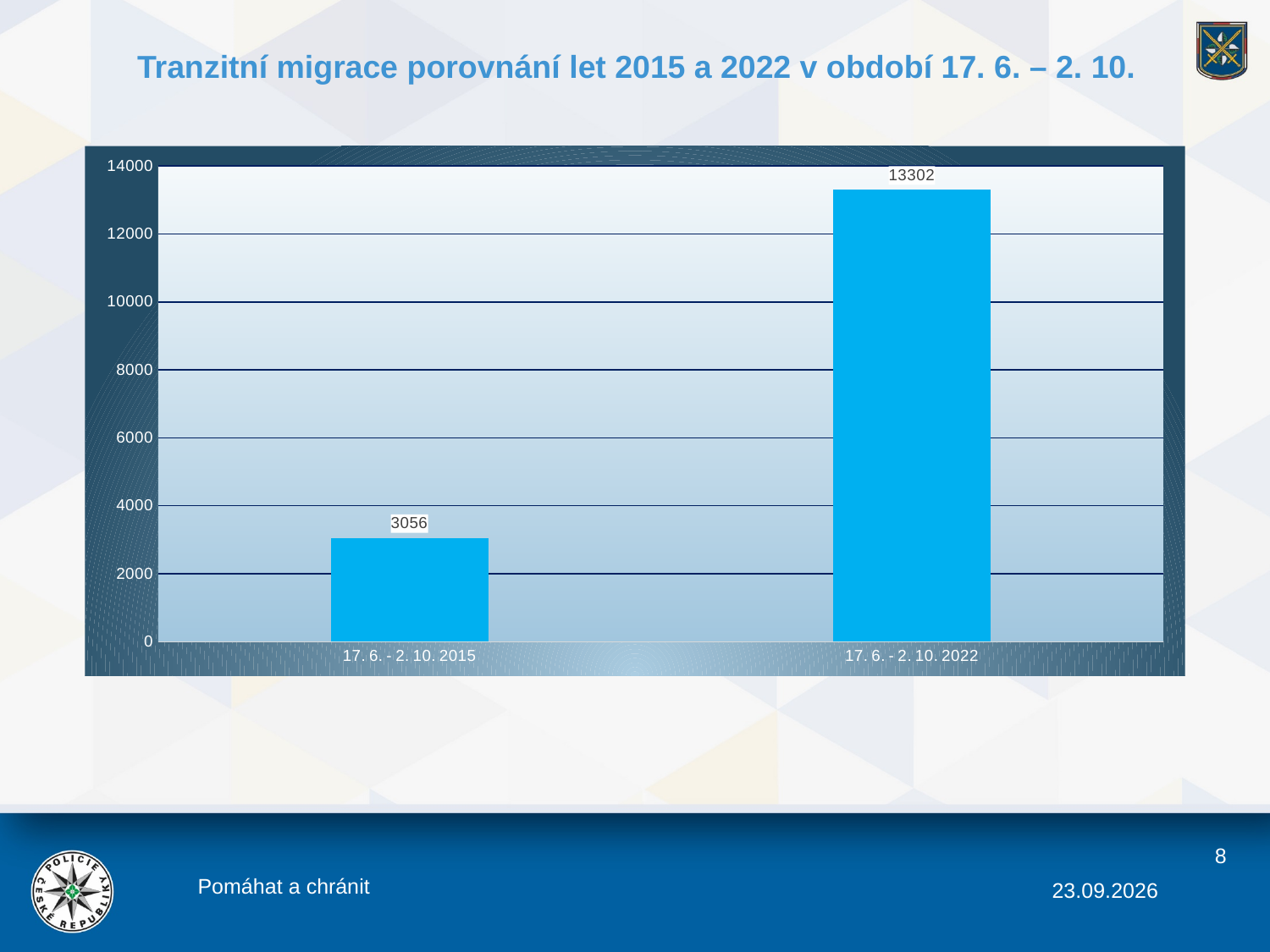
What is the title of the slide containing the chart? Tranzitní migrace porovnání let 2015 a 2022 v období 17. 6. – 2. 10. Which period has the lower value? 17. 6. - 2. 10. 2015 What is the value for 17. 6. - 2. 10. 2015? 3056 Which period has the higher value? 17. 6. - 2. 10. 2022 Do the values rise or fall from the 2015 period to the 2022 period? rise What is the difference between the values for 17. 6. - 2. 10. 2022 and 17. 6. - 2. 10. 2015? 10246 What is the value for 17. 6. - 2. 10. 2022? 13302 How many bars are shown in the chart? 2 Is the value for 17. 6. - 2. 10. 2022 greater or less than 12000? greater What kind of chart is shown on the slide? bar chart Is the value for 17. 6. - 2. 10. 2015 greater or less than 4000? less Is the value for 17. 6. - 2. 10. 2015 larger or smaller than the value for 17. 6. - 2. 10. 2022? smaller